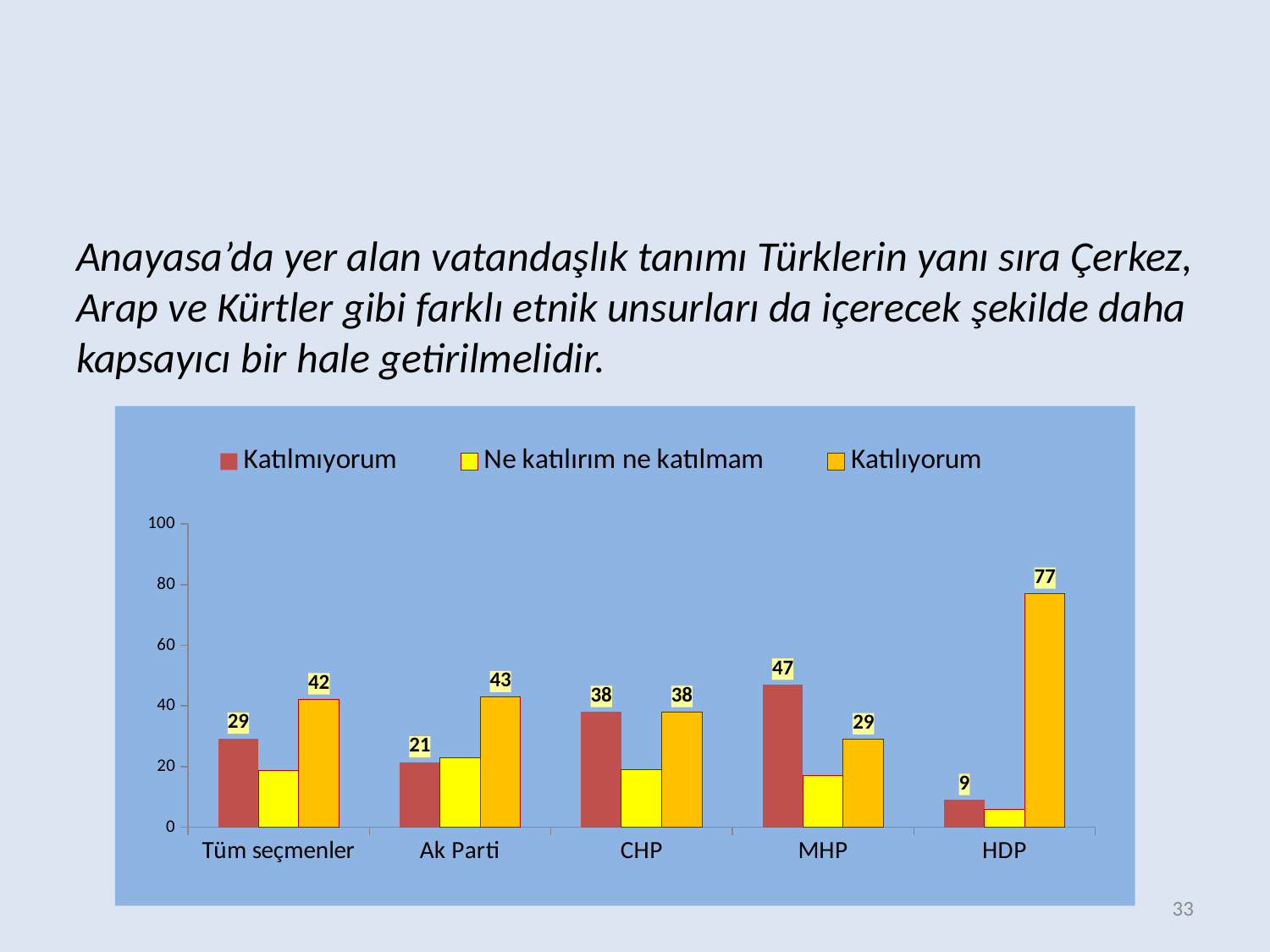
Is the value of Ne katılırım ne katılmam for HDP greater or less than 20? less What colour represents the Katılıyorum series? orange For HDP, what is the difference between the Katılıyorum and Katılmıyorum values? 68 What is the value of Katılmıyorum for MHP? 47 What is the value of Katılmıyorum for Ak Parti? 21 Which category has the highest Katılıyorum value? HDP What kind of chart is shown on the slide? bar chart How many categories are shown on the x axis? 5 For Tüm seçmenler, which is larger: Katılmıyorum or Katılıyorum? Katılıyorum What is the value of Katılıyorum for HDP? 77 Which category has the lowest Katılmıyorum value? HDP How many series does the legend list? 3